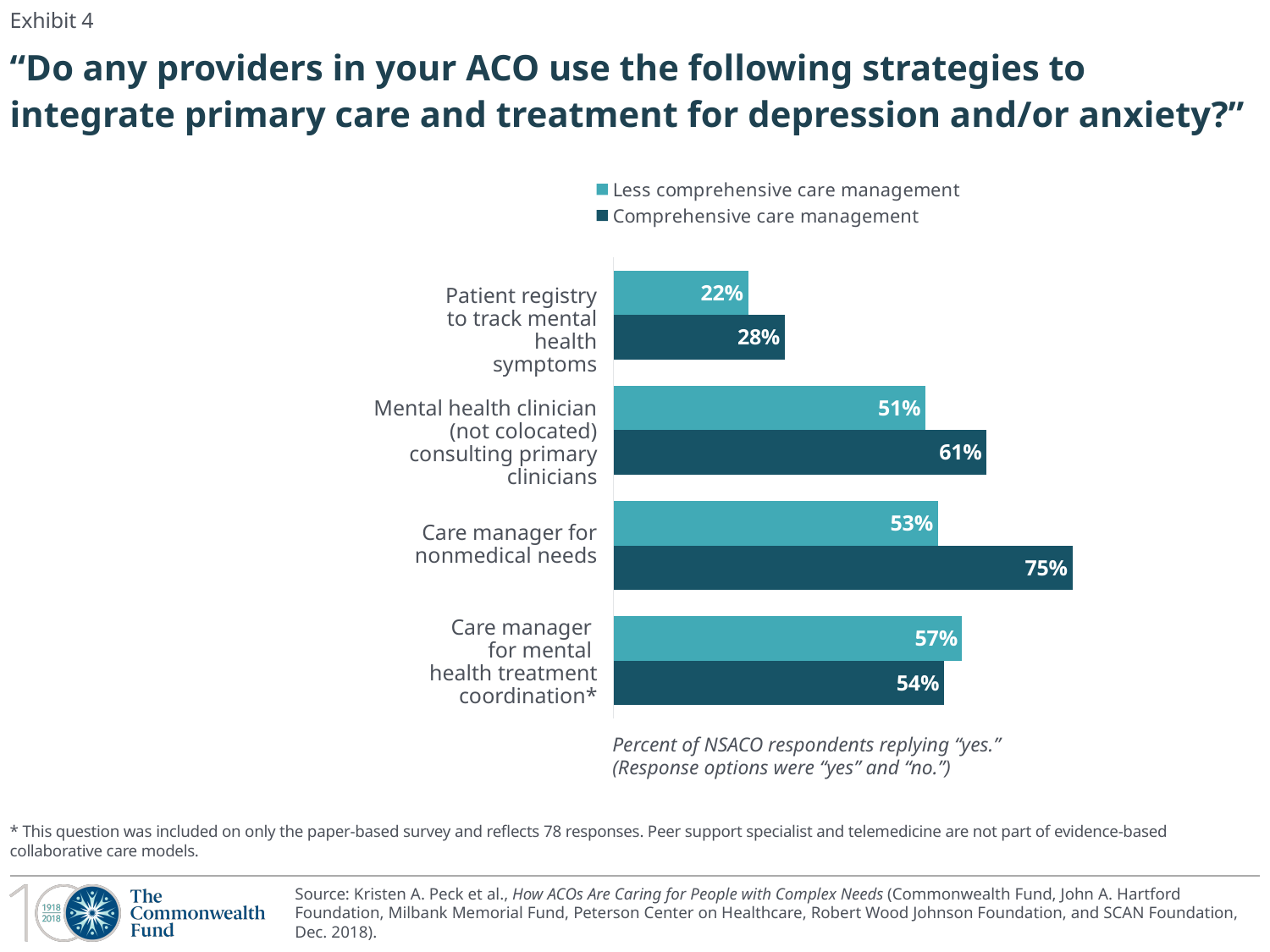
How many series does the legend list? 2 Which strategy has the lowest value for the 'Less comprehensive care management' series? Patient registry to track mental health symptoms What is the difference between the two series' values for 'Patient registry to track mental health symptoms'? 6 percentage points How many strategies (categories) are shown in the chart? 4 What percentage of respondents with comprehensive care management reported using a care manager for nonmedical needs? 75% What type of chart is shown on the slide? Bar chart Which strategy has the highest value for the 'Comprehensive care management' series? Care manager for nonmedical needs What is the value for 'Less comprehensive care management' for the patient registry to track mental health symptoms? 22% For 'Mental health clinician (not colocated) consulting primary clinicians', which series has the larger value? Comprehensive care management What is the difference between the comprehensive and less comprehensive care management values for 'Care manager for nonmedical needs'? 22 percentage points What percentage of respondents with less comprehensive care management reported a care manager for mental health treatment coordination? 57% For 'Care manager for mental health treatment coordination', which series has the larger value? Less comprehensive care management